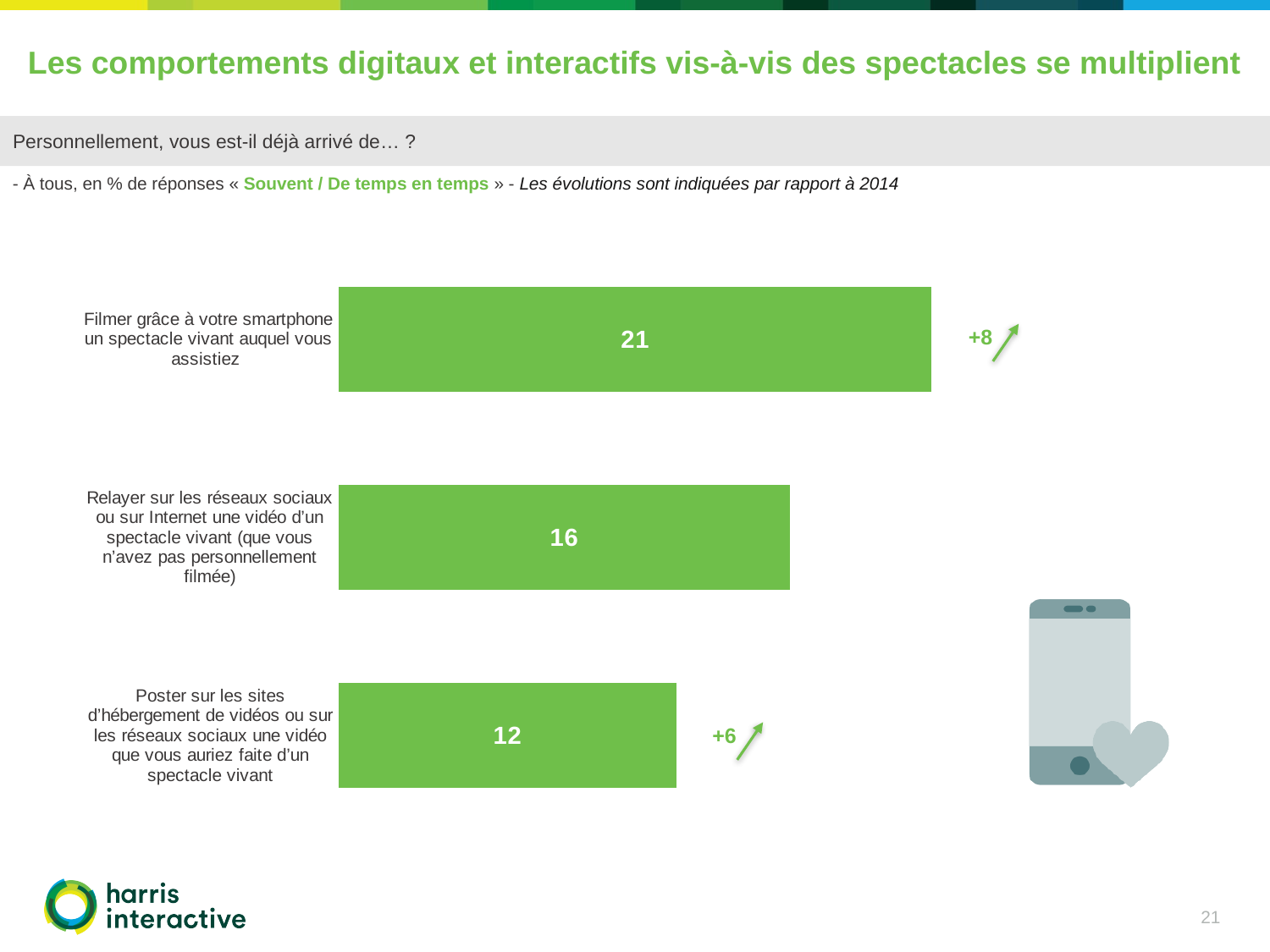
What is the value for "Filmer grâce à votre smartphone un spectacle vivant auquel vous assistiez"? 21 Which category has the lowest value? Poster sur les sites d'hébergement de vidéos ou les réseaux sociaux une vidéo que vous auriez faite d'un spectacle vivant What is the value for "Poster sur les sites d'hébergement de vidéos ou les réseaux sociaux une vidéo que vous auriez faite d'un spectacle vivant"? 12 What is the difference between the value for "Filmer grâce à votre smartphone..." and the value for "Poster sur les sites d'hébergement de vidéos..."? 9 Which is larger: the value for "Relayer sur les réseaux sociaux..." or the value for "Poster sur les sites d'hébergement de vidéos..."? Relayer sur les réseaux sociaux... What change since 2014 is indicated next to the bar for "Poster sur les sites d'hébergement de vidéos..."? +6 What is the difference between the value for "Filmer grâce à votre smartphone..." and the value for "Relayer sur les réseaux sociaux..."? 5 Which category has the highest value? Filmer grâce à votre smartphone un spectacle vivant auquel vous assistiez What change since 2014 is indicated next to the bar for "Filmer grâce à votre smartphone..."? +8 What kind of chart is shown on the slide? Bar chart How many categories are shown in the chart? 3 What is the value for "Relayer sur les réseaux sociaux ou sur Internet une vidéo d'un spectacle vivant (que vous n'avez pas personnellement filmée)"? 16